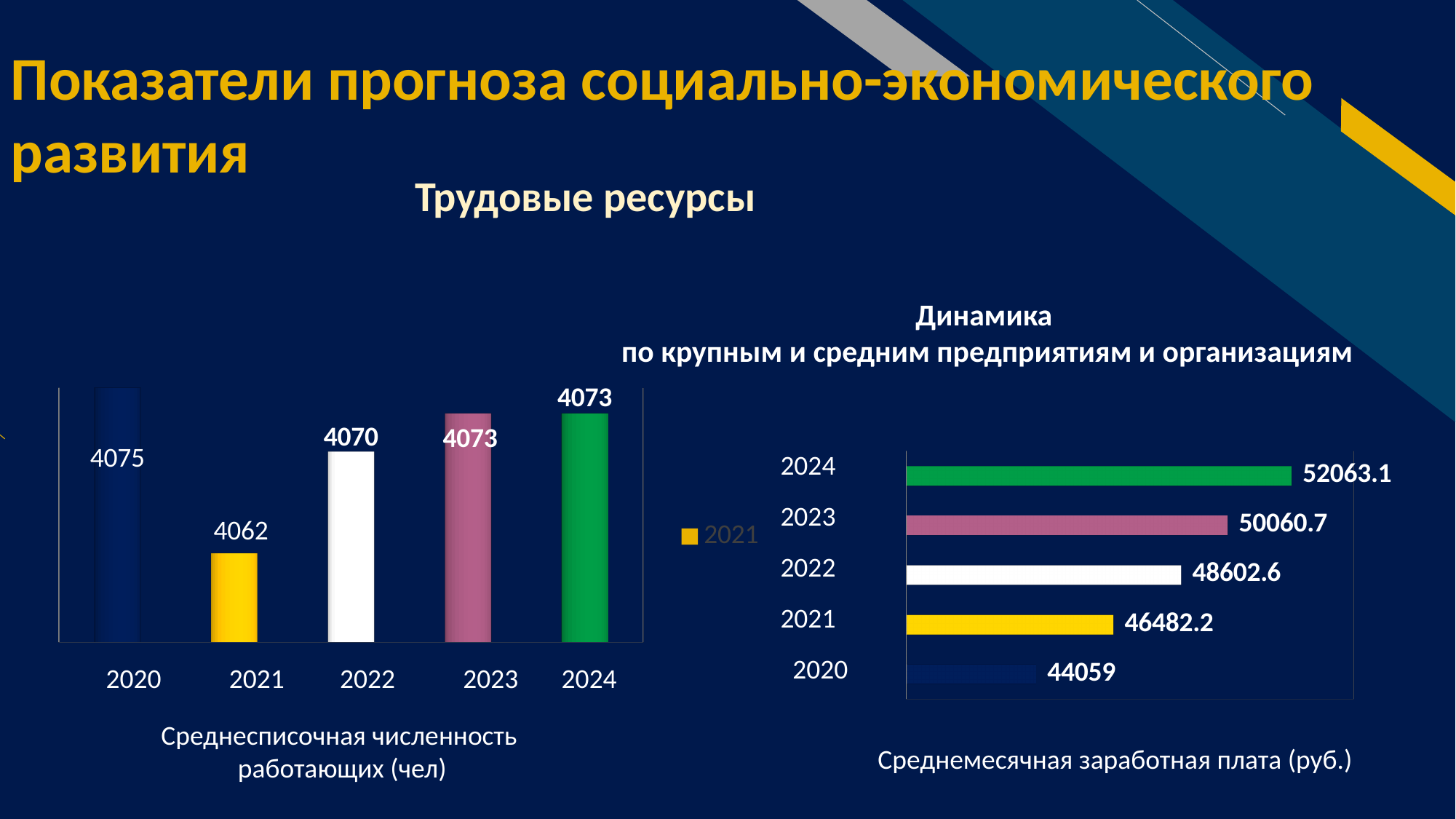
In the chart 'Среднемесячная заработная плата (руб.)', do the values rise or fall from 2020 to 2024? rise In the chart 'Среднемесячная заработная плата (руб.)', what is the value for 2022? 48602.6 In the chart 'Среднемесячная заработная плата (руб.)', what is the difference between the values for 2024 and 2020? 8004.1 In the chart 'Среднемесячная заработная плата (руб.)', which is larger: the value for 2023 or the value for 2022? 2023 In the chart 'Среднесписочная численность работающих (чел)', how many years are shown? 5 In the chart 'Среднемесячная заработная плата (руб.)', what is the value for 2020? 44059 In the chart 'Среднемесячная заработная плата (руб.)', which year has the highest value? 2024 In the chart 'Среднесписочная численность работающих (чел)', what is the difference between the values for 2020 and 2021? 13 In the chart 'Среднесписочная численность работающих (чел)', which year has the highest value? 2020 What kind of chart is 'Среднемесячная заработная плата (руб.)'? bar chart In the chart 'Среднесписочная численность работающих (чел)', what is the value for 2021? 4062 In the chart 'Среднесписочная численность работающих (чел)', which year has the lowest value? 2021